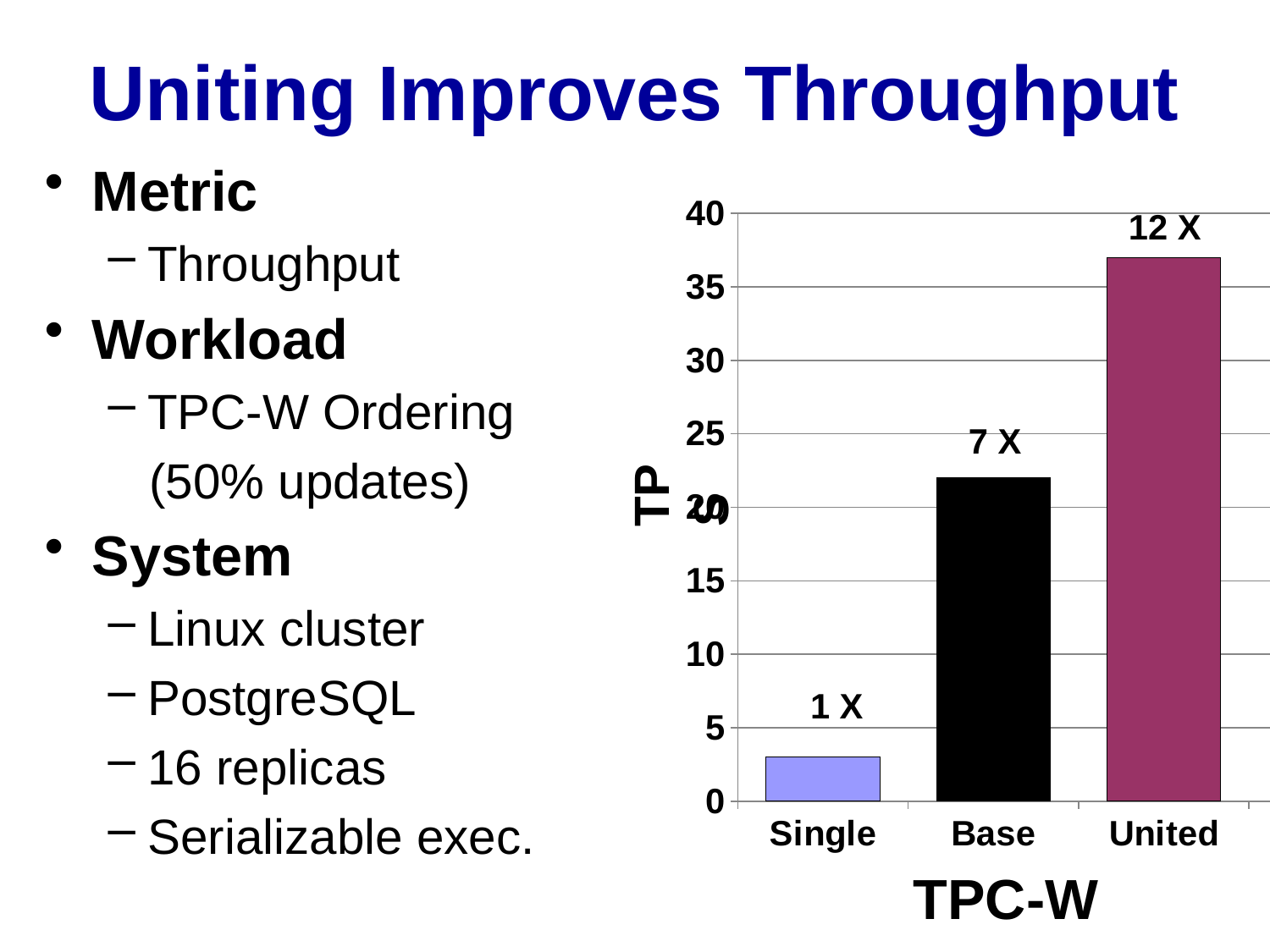
Which bar is taller, United or Base? United What is the title shown below the x axis of the chart? TPC-W Which category has the lowest bar in the chart? Single What label is printed above the United bar? 12 X How many categories are shown on the x axis of the chart? 3 Which category has the highest bar in the chart? United Is the value for Base greater or less than 20? greater Is the value for Single greater or less than 5? less What kind of chart is shown on the slide? bar chart Which bar is taller, Base or Single? Base Is the value for United greater or less than 35? greater Do the bar values rise or fall going from Single to United along the x axis? rise